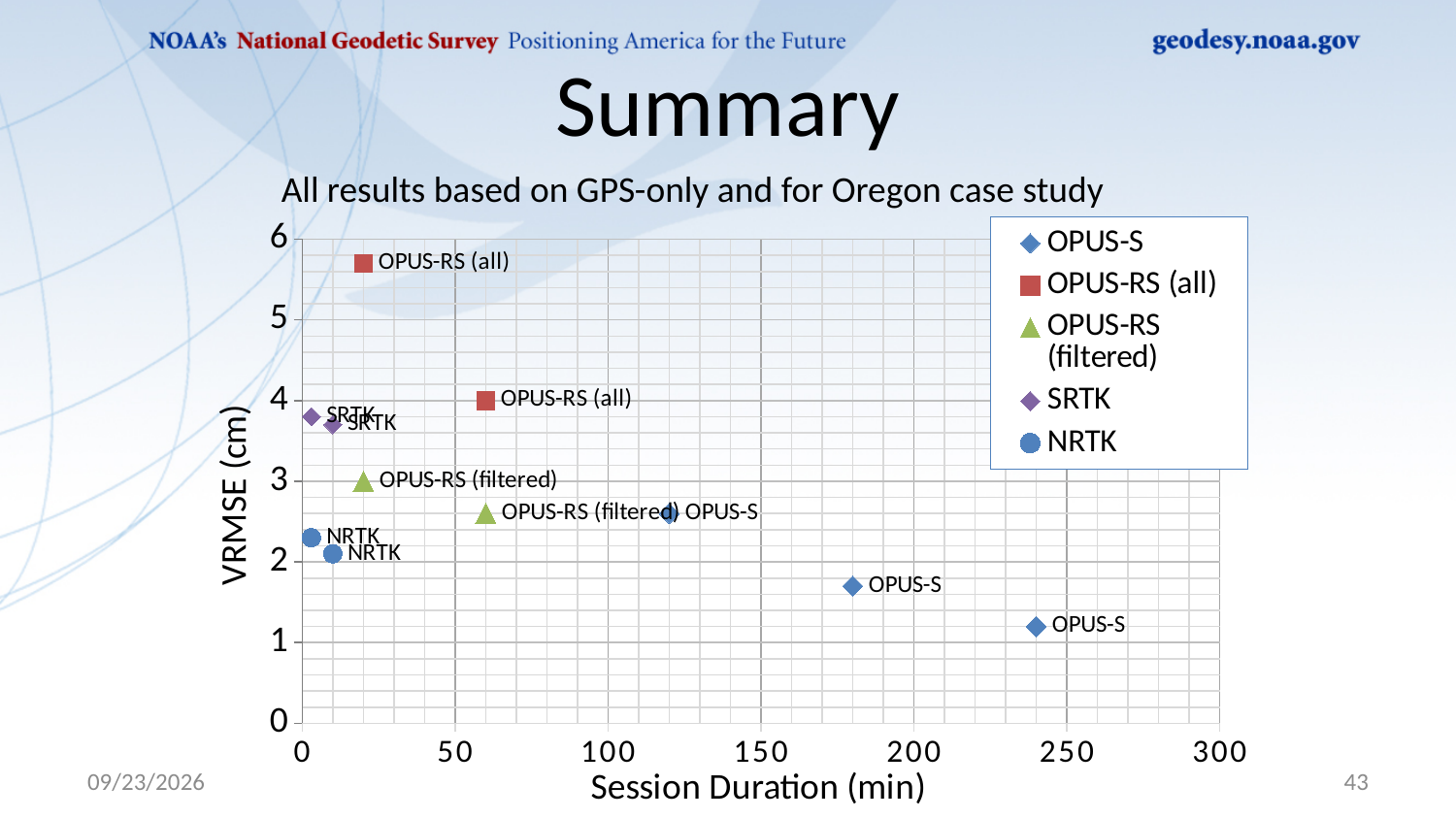
What kind of chart is shown on the slide? Scatter chart Is the VRMSE for the NRTK point at 10 minutes greater or less than 3? less At a session duration of 20 minutes, which has the larger VRMSE: OPUS-RS (all) or OPUS-RS (filtered)? OPUS-RS (all) Does the VRMSE for OPUS-S rise or fall as session duration increases? Fall What is the title of the y axis? VRMSE (cm) Is the VRMSE for the OPUS-S point at 240 minutes greater or less than 2? less What is the title of the x axis? Session Duration (min) How many OPUS-S points are plotted? 3 Is the VRMSE for the OPUS-RS (all) point at 20 minutes greater or less than 5? greater Which series has the point with the highest VRMSE? OPUS-RS (all) How many series does the legend list? 5 Which series has the point with the lowest VRMSE? OPUS-S